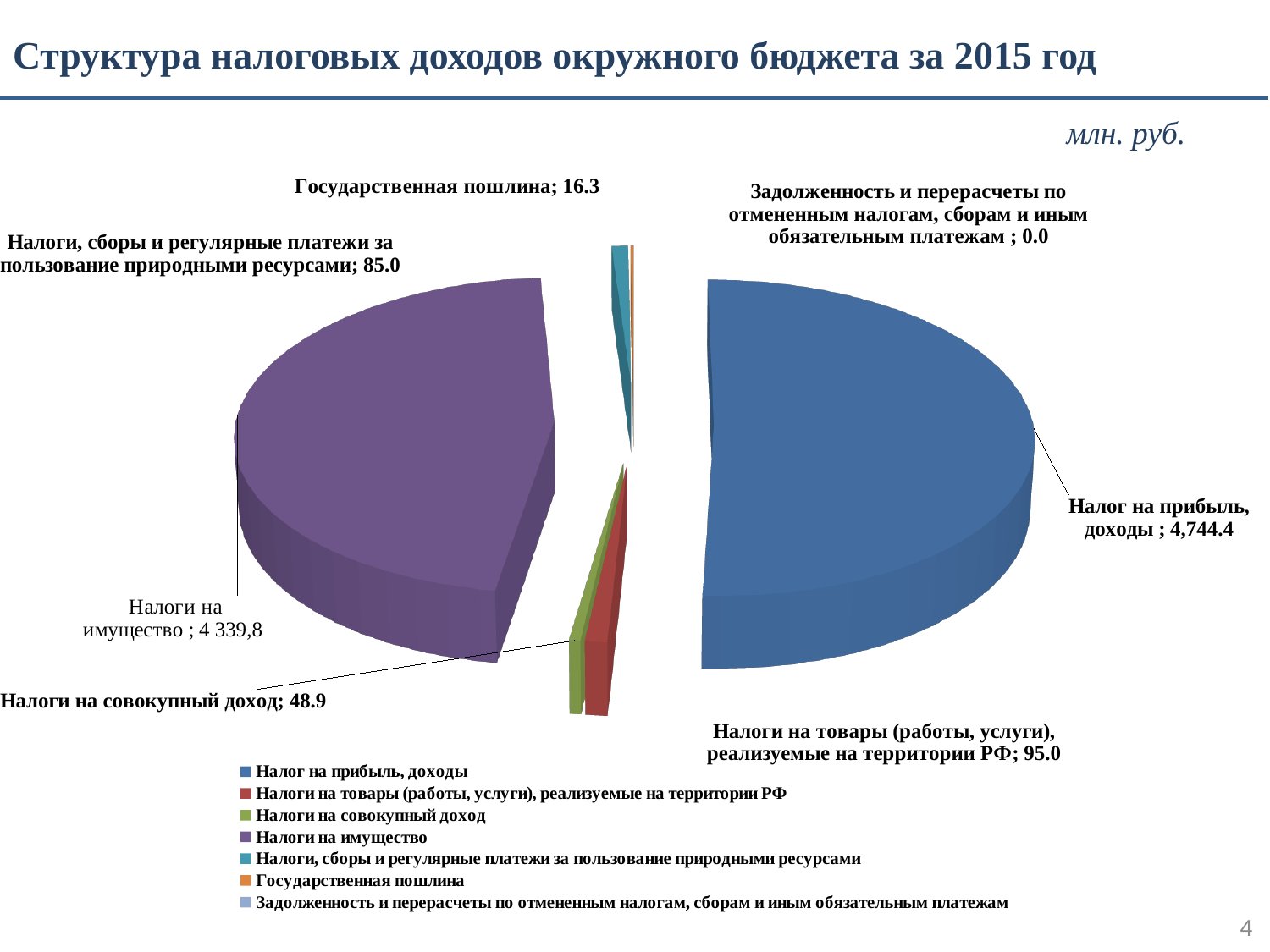
What is the value for "Государственная пошлина"? 16.3 What is the value for "Налоги на совокупный доход"? 48.9 Which category has the largest value in the pie chart? Налог на прибыль, доходы Which is larger: "Налог на прибыль, доходы" or "Налоги на имущество"? Налог на прибыль, доходы What unit is indicated for the values on the slide? млн. руб. What type of chart is shown on the slide? Pie chart What is the value for "Налог на прибыль, доходы"? 4,744.4 What is the value for "Налоги на товары (работы, услуги), реализуемые на территории РФ"? 95.0 Which category has the smallest value in the pie chart? Задолженность и перерасчеты по отмененным налогам, сборам и иным обязательным платежам What is the value for "Налоги на имущество"? 4 339,8 How many categories does the legend list? 7 What is the difference between "Налоги на товары (работы, услуги), реализуемые на территории РФ" and "Налоги, сборы и регулярные платежи за пользование природными ресурсами"? 10.0